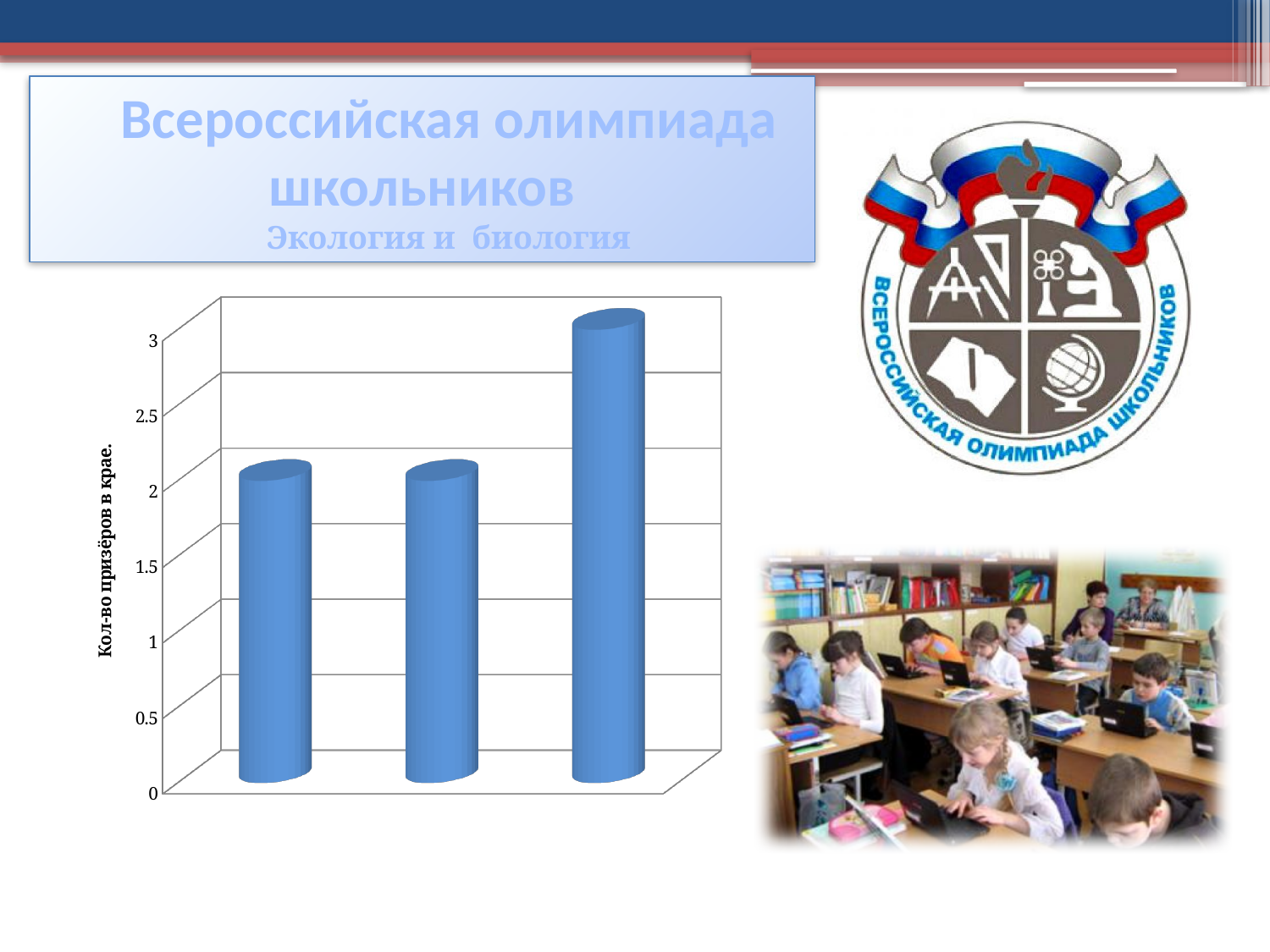
What is the value of the second (middle) bar in the chart? 2 Is the value of the leftmost bar greater or less than 2.5? less How many bars does the chart show? 3 Which bar in the chart is the highest? the third (rightmost) bar Do the bar values rise or fall from left to right across the chart? rise What is the difference between the value of the third bar and the value of the first bar? 1 What kind of chart is shown on the slide? bar chart What is the value of the first (leftmost) bar in the chart? 2 What is the label of the vertical axis of the chart? Кол-во призёров в крае. Which is larger, the value of the third bar or the value of the second bar? the third bar What is the value of the third (rightmost) bar in the chart? 3 Is the value of the rightmost bar greater or less than 2.5? greater